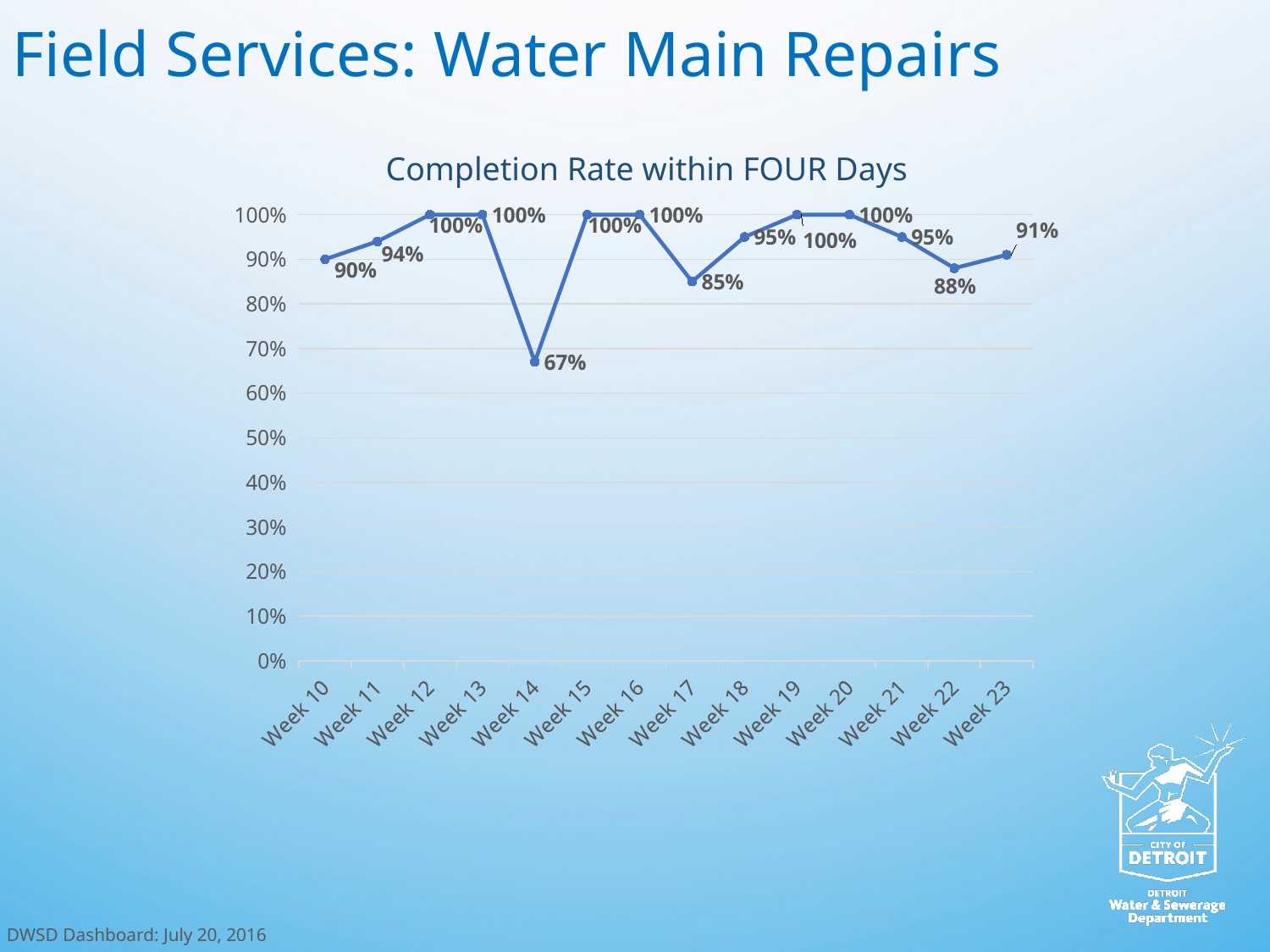
What is the completion rate for Week 17? 85% What is the completion rate for Week 22? 88% Does the completion rate rise or fall from Week 21 to Week 22? fall What is the title of the chart? Completion Rate within FOUR Days How many weeks are plotted on the chart? 14 What is the completion rate for Week 14? 67% Is the completion rate for Week 14 greater or less than 70%? less Which week has the lowest completion rate? Week 14 Which is larger, the completion rate for Week 11 or Week 23? Week 11 What is the completion rate for Week 10? 90% What type of chart is shown on the slide? line chart What is the difference between the completion rates for Week 13 and Week 14? 33%